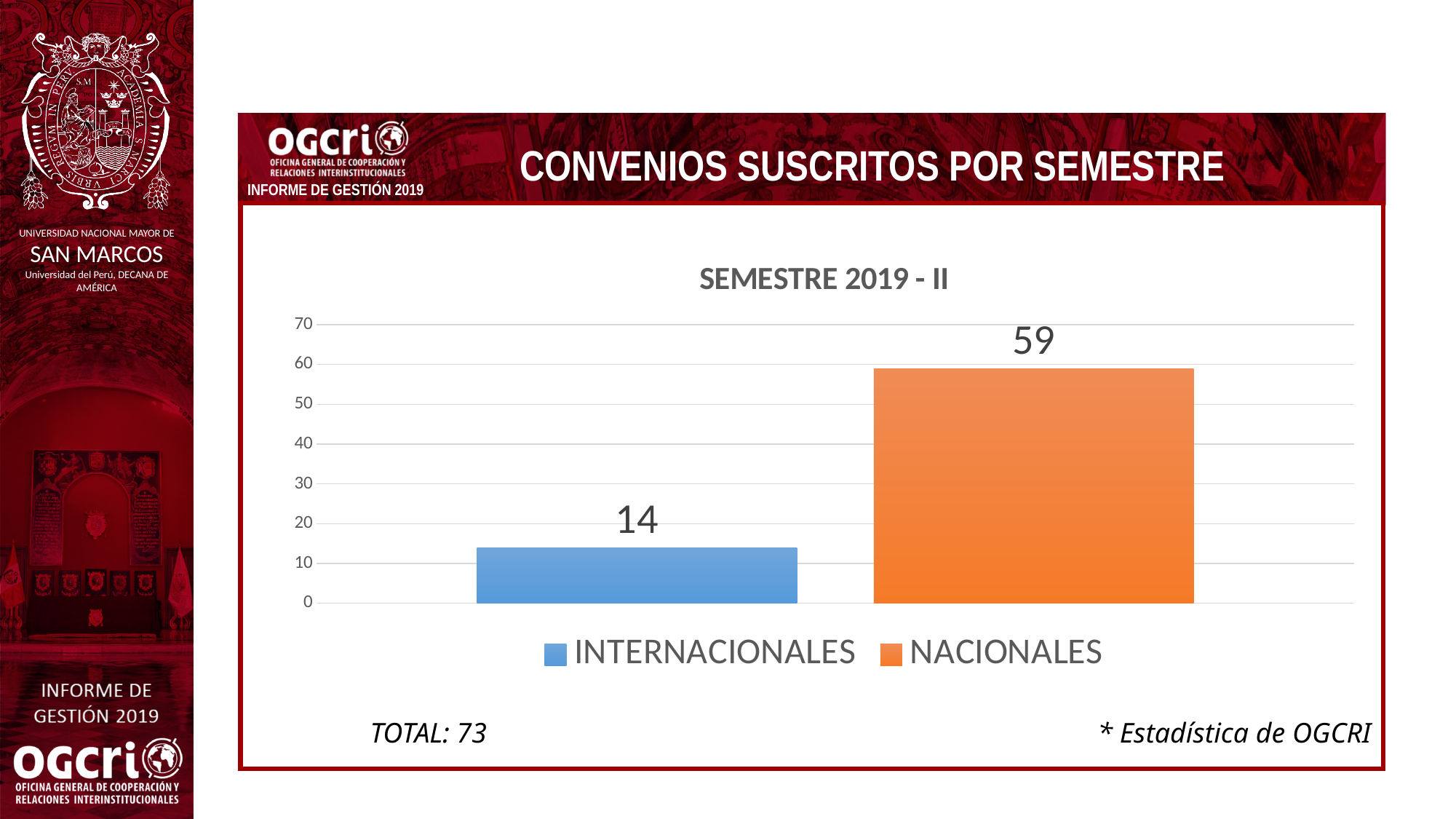
What kind of chart is shown? bar chart What is the difference between the NACIONALES and INTERNACIONALES values? 45 What is the value for NACIONALES? 59 Which series has the lowest value? INTERNACIONALES What is the title of the chart? SEMESTRE 2019 - II How many series does the legend list? 2 Is the value for NACIONALES greater or less than 50? greater Which series has the highest value? NACIONALES Which is larger, INTERNACIONALES or NACIONALES? NACIONALES Is the value for INTERNACIONALES greater or less than 20? less What is the total of the two values shown in the chart? 73 What is the value for INTERNACIONALES? 14